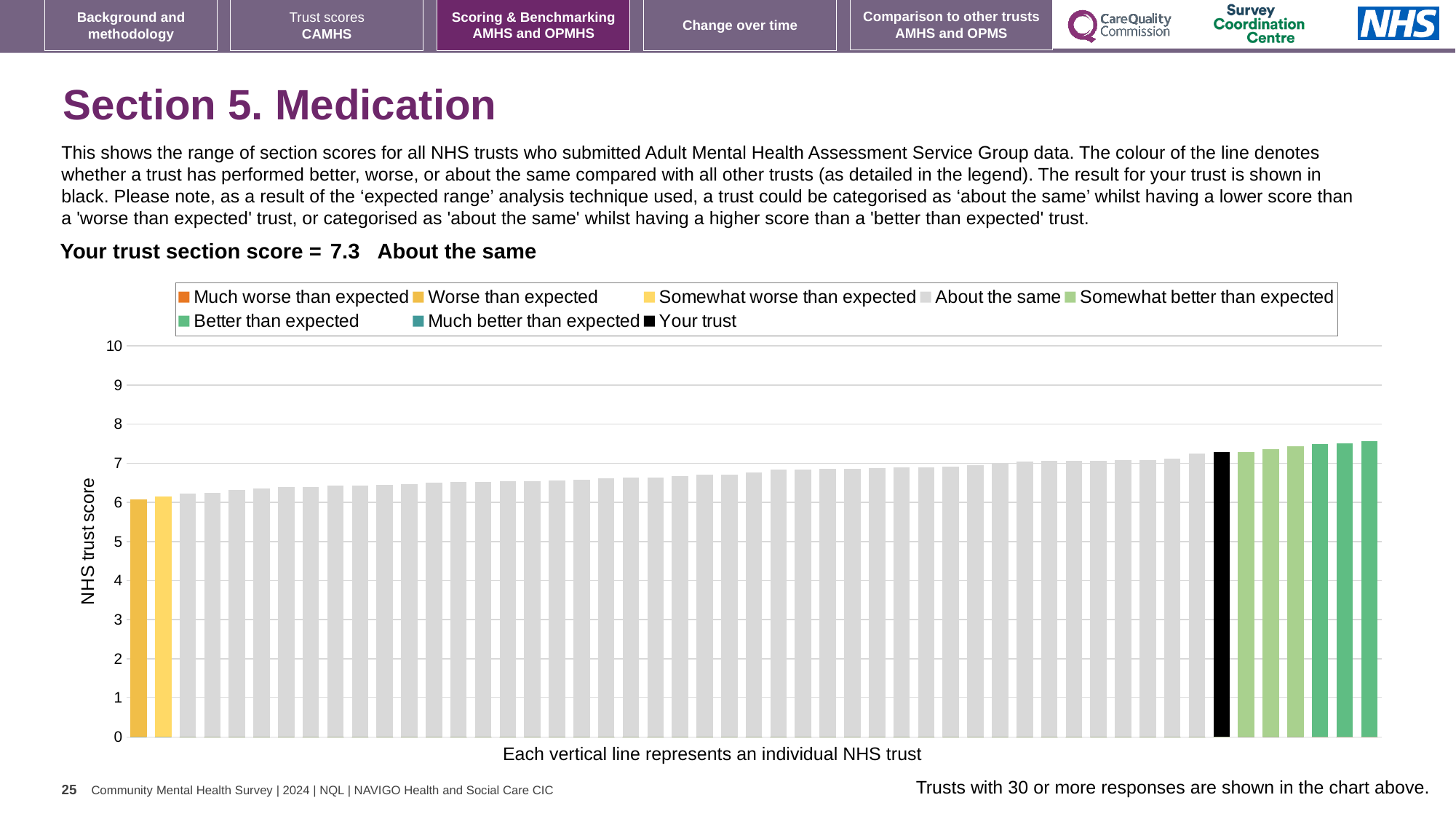
Is the value of the black 'Your trust' bar greater or less than 7? greater Is the 'Your trust' bar higher or lower than the leftmost bar? higher What is the label on the vertical axis of the chart? NHS trust score What colour is the bar representing your trust? black Which category is your trust's section score placed in? About the same What is the section score for your trust shown on the slide? 7.3 What kind of chart is shown on the slide? bar chart Is the value of the leftmost bar greater or less than 7? less How many bars are coloured as 'Better than expected'? 3 Do the bar values rise or fall from left to right along the x axis? rise Is the value of the rightmost bar greater or less than 8? less How many entries does the chart legend list? 8